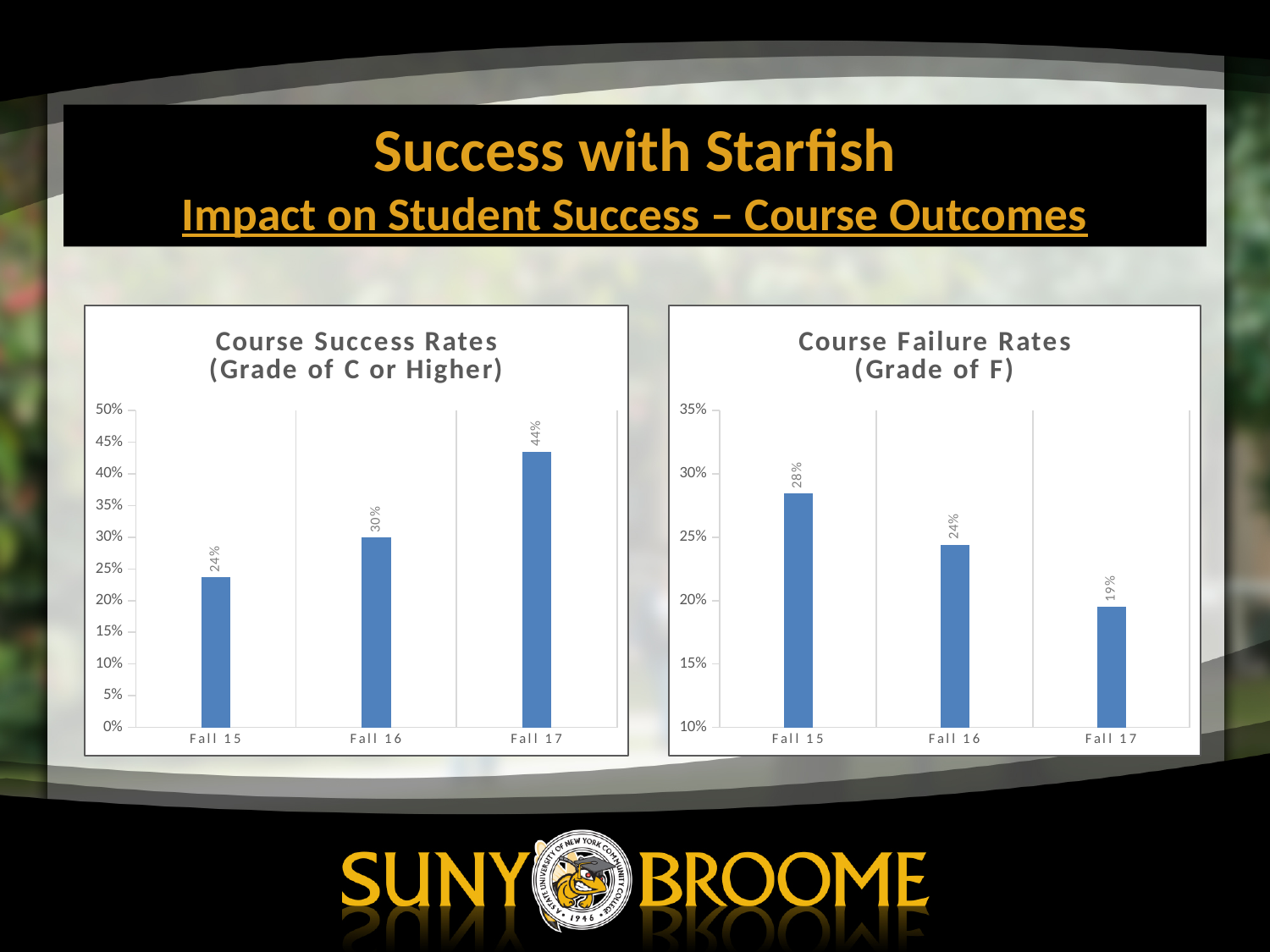
In the Course Failure Rates chart, what is the value for Fall 15? 28% How many terms are shown in the Course Success Rates chart? 3 In the Course Failure Rates chart, which term has the highest failure rate? Fall 15 In the Course Failure Rates chart, which is larger, the value for Fall 16 or Fall 17? Fall 16 In the Course Success Rates chart, is the value for Fall 16 greater or less than 25%? greater In the Course Success Rates chart, what is the difference between the Fall 17 and Fall 15 values? 20% What kind of chart is the Course Failure Rates chart? Bar chart What is the subtitle of the Course Success Rates chart shown in parentheses? Grade of C or Higher In the Course Success Rates chart, what is the value for Fall 17? 44% In the Course Failure Rates chart, what is the difference between the Fall 15 and Fall 17 values? 9% In the Course Failure Rates chart, do the values rise or fall from Fall 15 to Fall 17? Fall In the Course Success Rates chart, which term has the lowest success rate? Fall 15